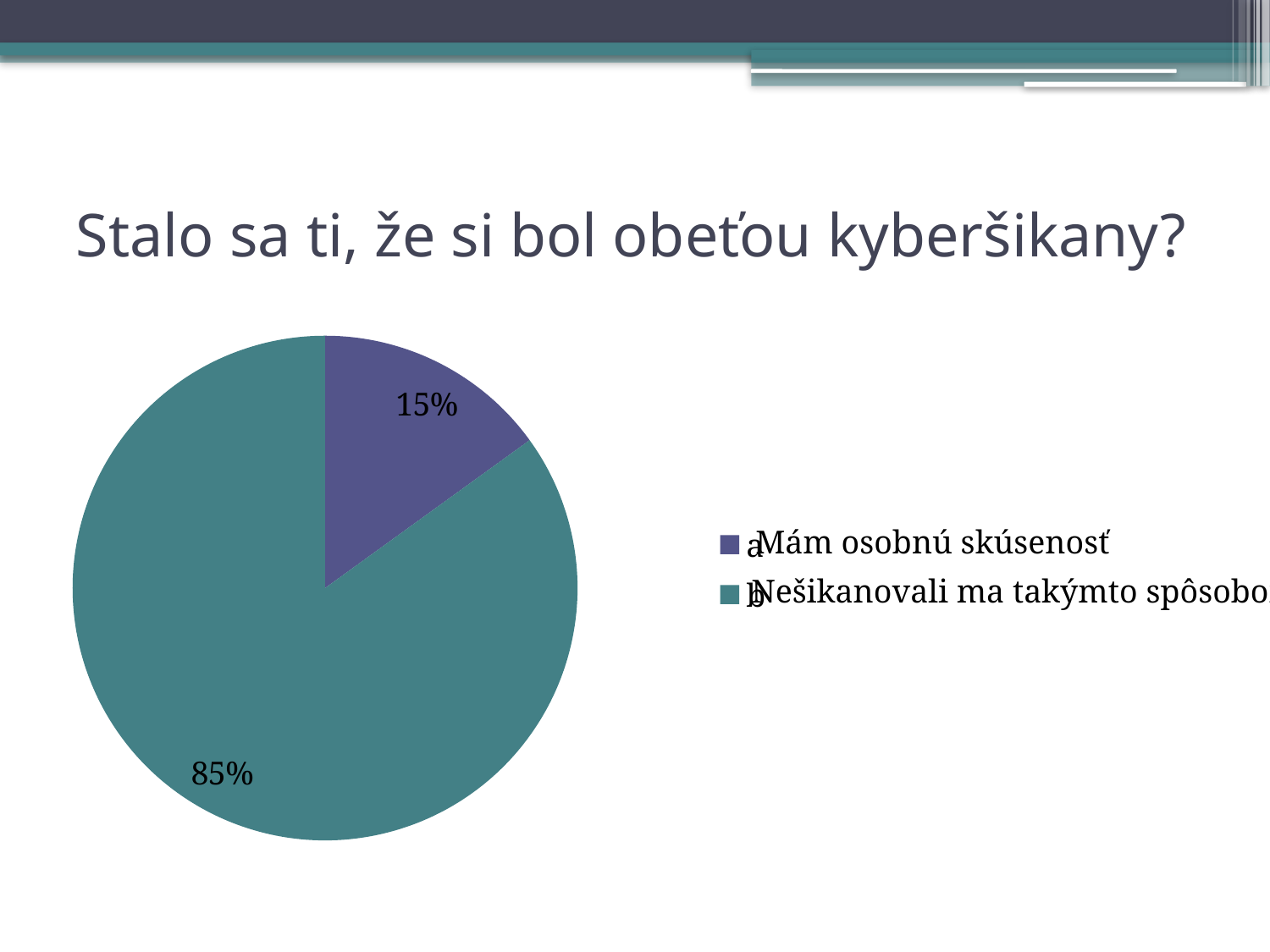
What is the difference in percentage points between the two slices of the pie chart? 70 How many slices does the pie chart have? 2 What percentage is shown for the teal slice ("Nešikanovali ma takýmto spôsobom")? 85% What is the title of the slide containing the pie chart? Stalo sa ti, že si bol obeťou kyberšikany? Which slice of the pie chart is the largest? Nešikanovali ma takýmto spôsobom What kind of chart is shown on the slide? pie chart What percentage is shown for the slice labelled "Mám osobnú skúsenosť"? 15% Which is larger: the slice for "Mám osobnú skúsenosť" or the slice for "Nešikanovali ma takýmto spôsobom"? Nešikanovali ma takýmto spôsobom What colour is the slice labelled 15%? purple How many entries does the legend of the pie chart list? 2 Which slice of the pie chart is the smallest? Mám osobnú skúsenosť What share of the pie does the purple slice represent? 15%